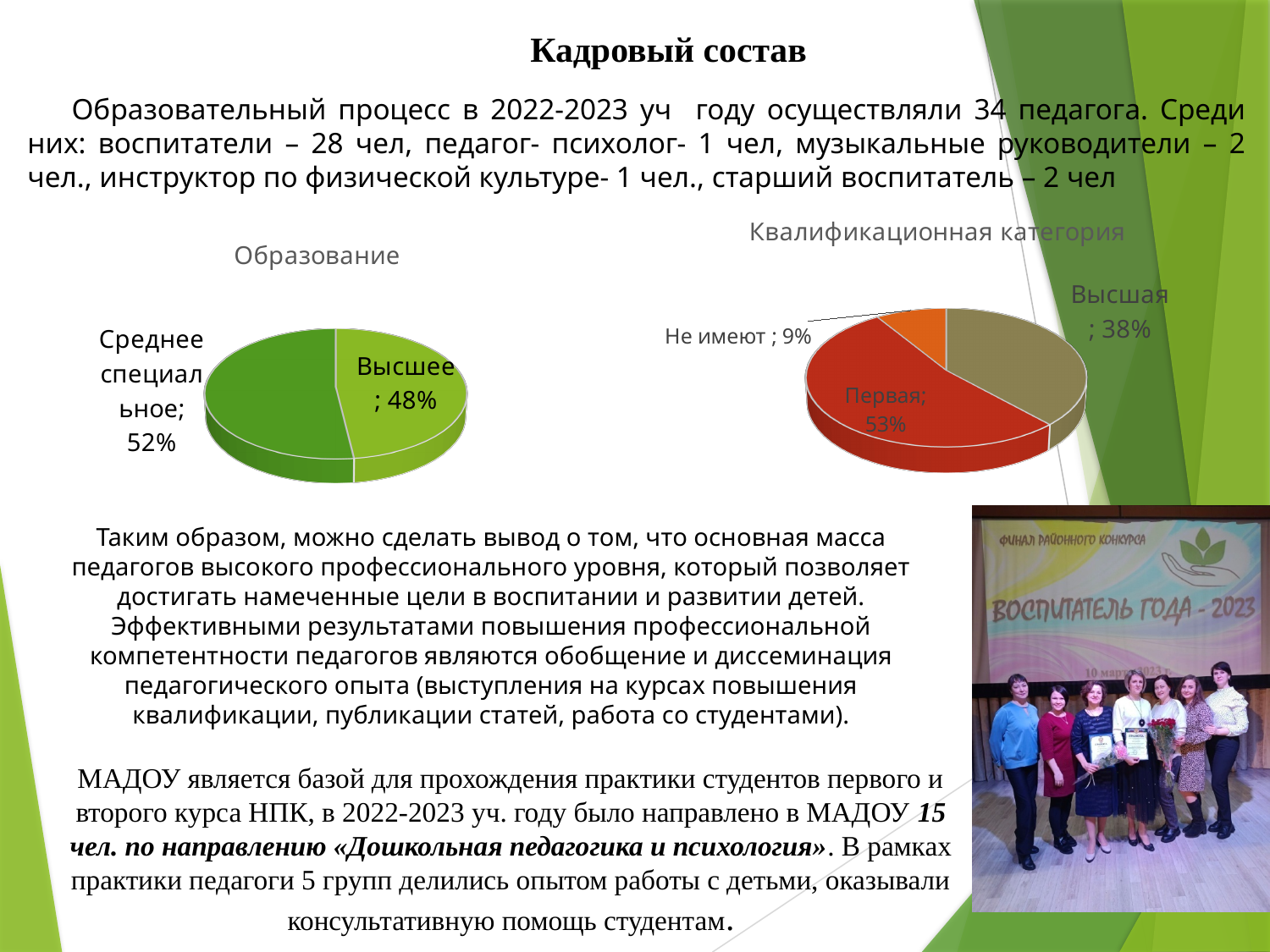
How many slices does the "Образование" chart have? 2 In the "Образование" chart, which slice is larger: "Высшее" or "Среднее специальное"? Среднее специальное In the "Квалификационная категория" chart, what share is labelled "Не имеют"? 9% What kind of chart is the "Образование" chart? pie chart How many slices does the "Квалификационная категория" chart have? 3 In the "Квалификационная категория" chart, what share is labelled "Высшая"? 38% In the "Образование" chart, what share is labelled "Высшее"? 48% In the "Квалификационная категория" chart, what share is labelled "Первая"? 53% In the "Образование" chart, what share is labelled "Среднее специальное"? 52% In the "Квалификационная категория" chart, which category has the smallest share? Не имеют In the "Квалификационная категория" chart, which category has the largest share? Первая In the "Образование" chart, what is the difference between the "Среднее специальное" and "Высшее" shares? 4%